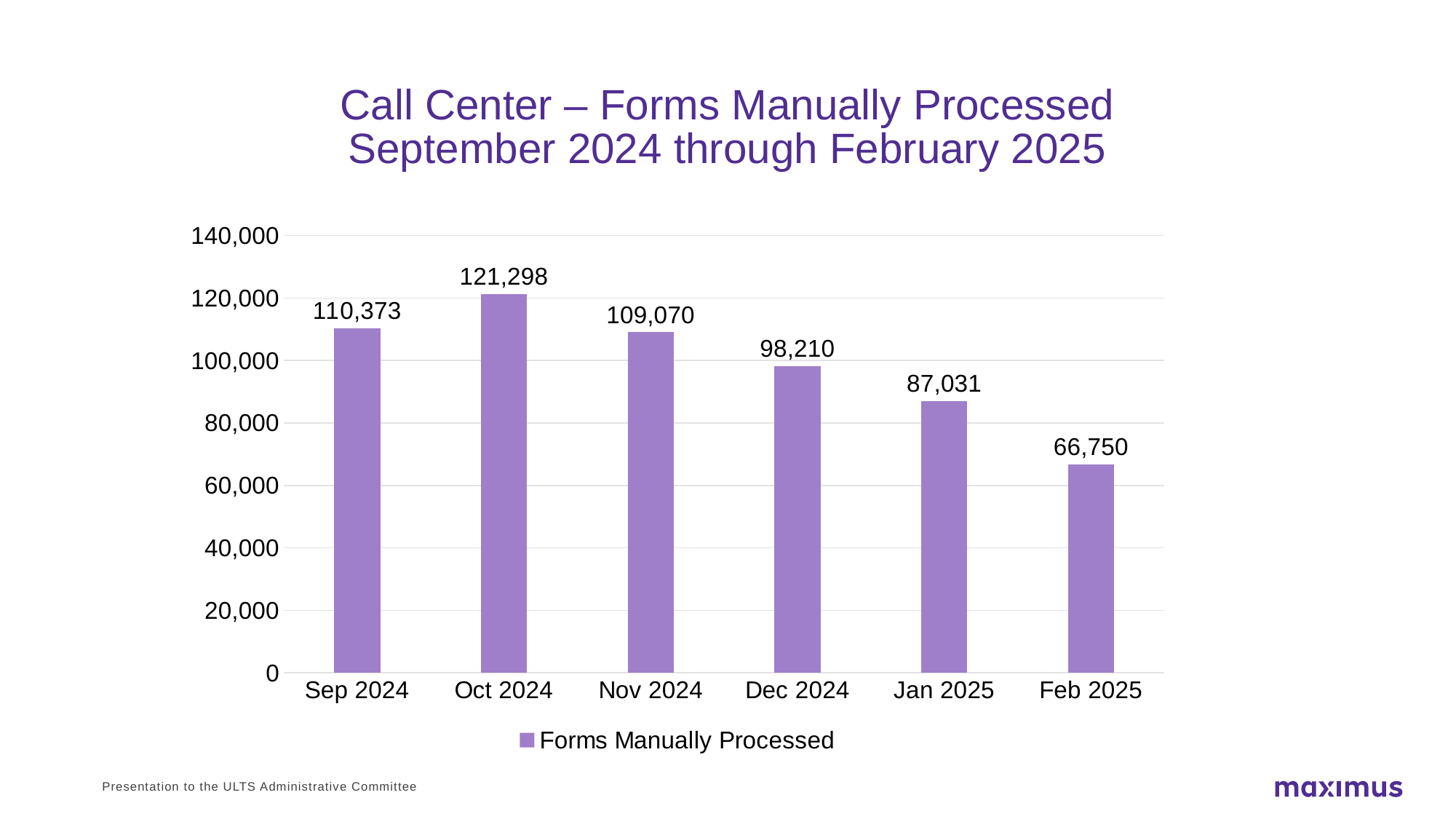
Which is larger, the value for Jan 2025 or the value for Dec 2024? Dec 2024 What is the value for Dec 2024? 98,210 Which month has the lowest number of forms manually processed? Feb 2025 From Oct 2024 to Feb 2025, do the values rise or fall? fall Is the value for Jan 2025 greater or less than 100,000? less Which month has the highest number of forms manually processed? Oct 2024 What is the difference between the values for Oct 2024 and Feb 2025? 54,548 How many months are shown on the x axis? 6 What is the difference between the values for Sep 2024 and Nov 2024? 1,303 What kind of chart is shown on the slide? bar chart What is the value for Feb 2025? 66,750 How many forms were manually processed in Oct 2024? 121,298